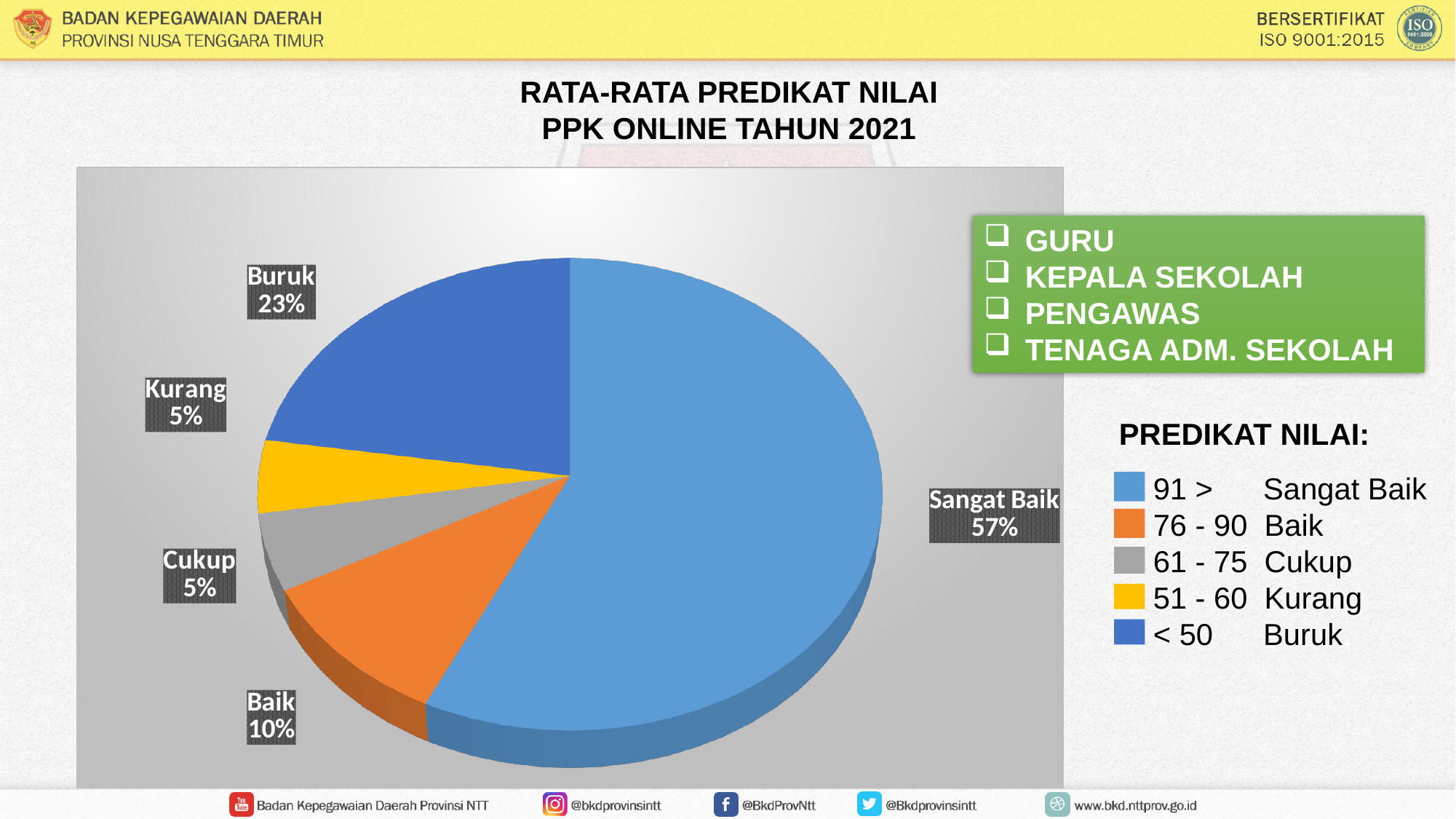
What is the difference in percentage points between Sangat Baik and Buruk? 34 What is the title of the chart? RATA-RATA PREDIKAT NILAI PPK ONLINE TAHUN 2021 What colour is the Kurang slice? yellow How many slices does the pie chart have? 5 What share of the pie does Baik have? 10% What share of the pie does Buruk have? 23% Which category has the largest slice of the pie? Sangat Baik What share of the pie does Kurang have? 5% What is the difference in percentage points between Buruk and Baik? 13 Which is larger, the Buruk slice or the Baik slice? Buruk What kind of chart is shown on the slide? pie chart